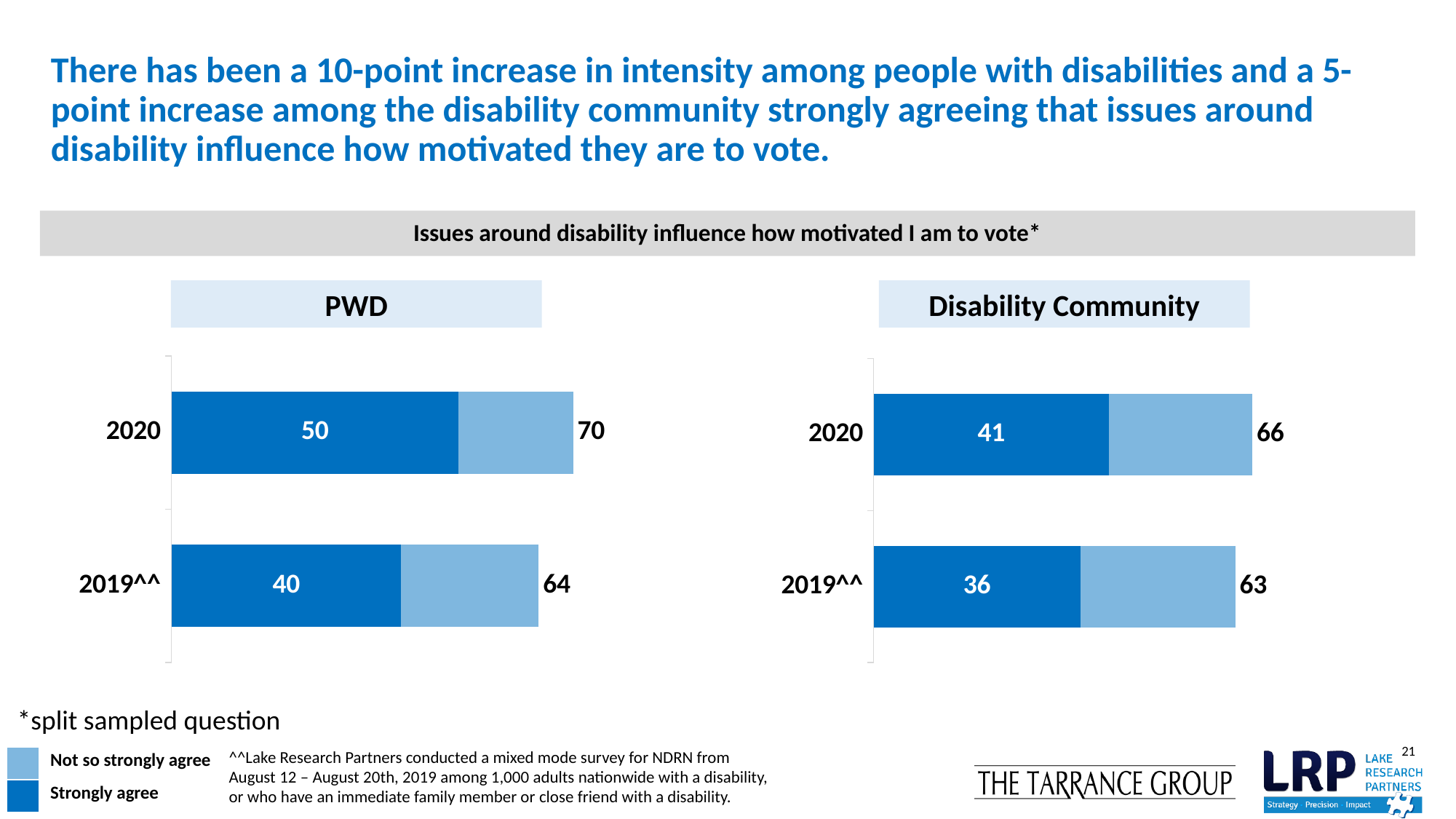
In the Disability Community chart, what is the Strongly agree value for 2019^^? 36 In the PWD chart, what is the difference between the Strongly agree values for 2020 and 2019^^? 10 What type of chart is used for the PWD data? Stacked bar chart In the Disability Community chart, what is the difference between the Strongly agree values for 2020 and 2019^^? 5 How many categories (years) does the PWD chart show? 2 In the PWD chart, what is the total value shown for 2019^^? 64 How many series does the legend list? 2 In the PWD chart, which year has the higher total value? 2020 In the Disability Community chart, which year has the lower Strongly agree value? 2019^^ In the Disability Community chart, what is the total value shown for 2020? 66 In the PWD chart, what is the Strongly agree value for 2020? 50 Is the 2020 Strongly agree value larger in the PWD chart or the Disability Community chart? PWD